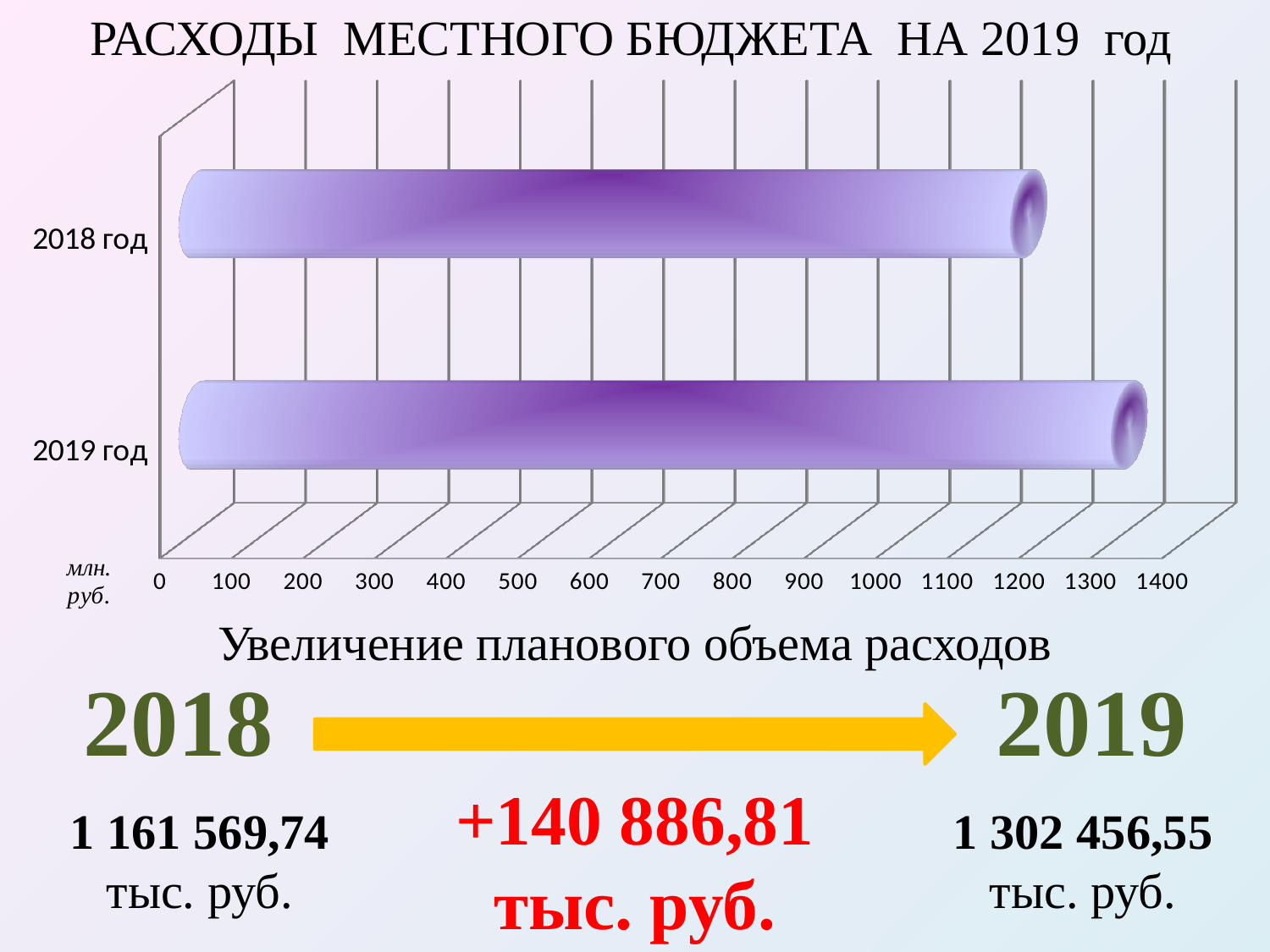
Is the value for 2018 год greater or less than 1100 on the axis? greater Which category has the highest value in the chart? 2019 год What unit is shown on the horizontal axis of the chart? млн. руб. According to the slide, what is the 2018 expenditure amount in тыс. руб.? 1 161 569,74 тыс. руб. Is the value for 2018 год greater or less than 1200 on the axis? less Is the value for 2019 год greater or less than 1400 on the axis? less Which category has the lowest value in the chart? 2018 год How many categories (bars) does the chart show? 2 What kind of chart is shown on the slide? bar chart According to the slide, what is the 2019 expenditure amount in тыс. руб.? 1 302 456,55 тыс. руб. Which year has the larger local budget expenditure bar, 2018 год or 2019 год? 2019 год